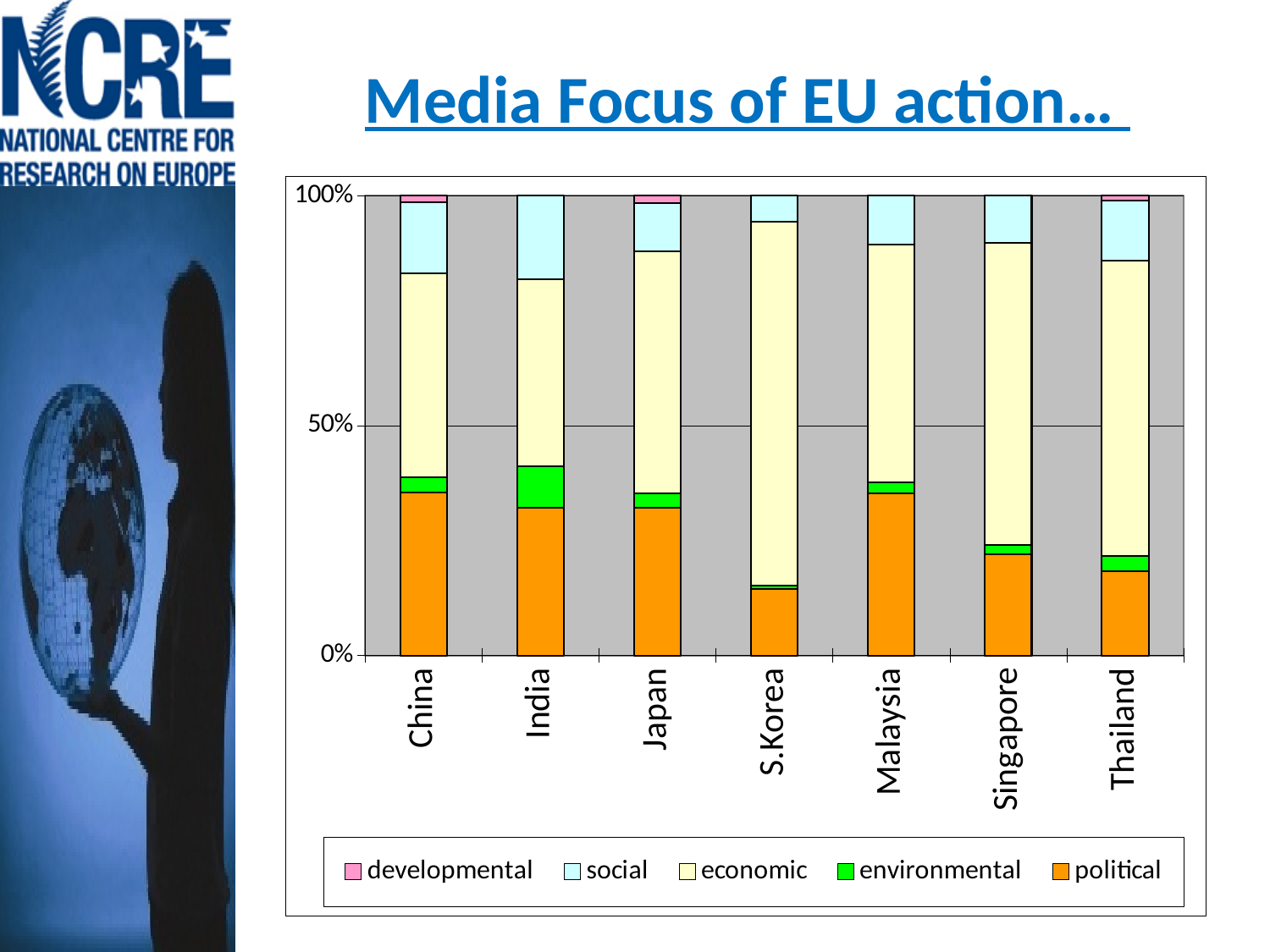
Which is larger, the political share for China or for S.Korea? China Is the political share for China greater or less than 50%? less What is the title of the slide containing the chart? Media Focus of EU action… Which series is shown in orange in the chart? political Which is larger, the political share for Malaysia or for Singapore? Malaysia Is the political share for S.Korea greater or less than 50%? less Which country has the lowest political share in the chart? S.Korea What kind of chart is shown on the slide? Stacked bar chart How many series does the chart's legend list? 5 How many countries are shown on the x axis of the chart? 7 What does each stacked bar in the chart total? 100% Which country has the largest environmental segment in the chart? India